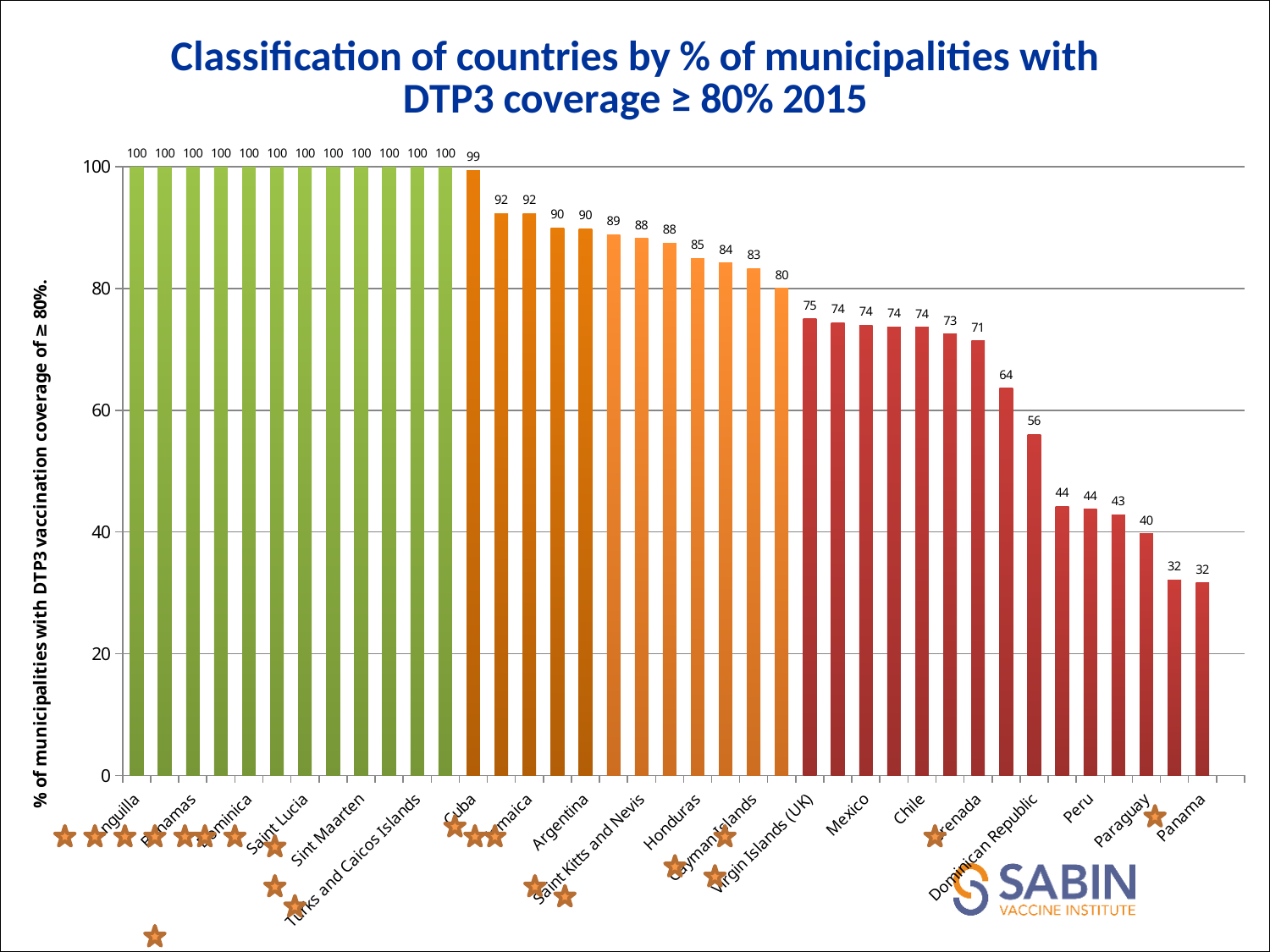
What kind of chart is shown on the slide? bar chart What is the value for Dominican Republic? 56 What is the title of the y axis? % of municipalities with DTP3 vaccination coverage of ≥ 80%. What is the difference between the values for Cuba and Panama? 67 Which has a higher value, Honduras or Mexico? Honduras What is the value for Panama? 32 What is the value for Argentina? 90 What is the value for Cuba? 99 What is the lowest value shown in the chart? 32 Is the value for Peru greater or less than 60? less What is the value for Paraguay? 40 Do the values rise or fall from left to right along the x axis? fall